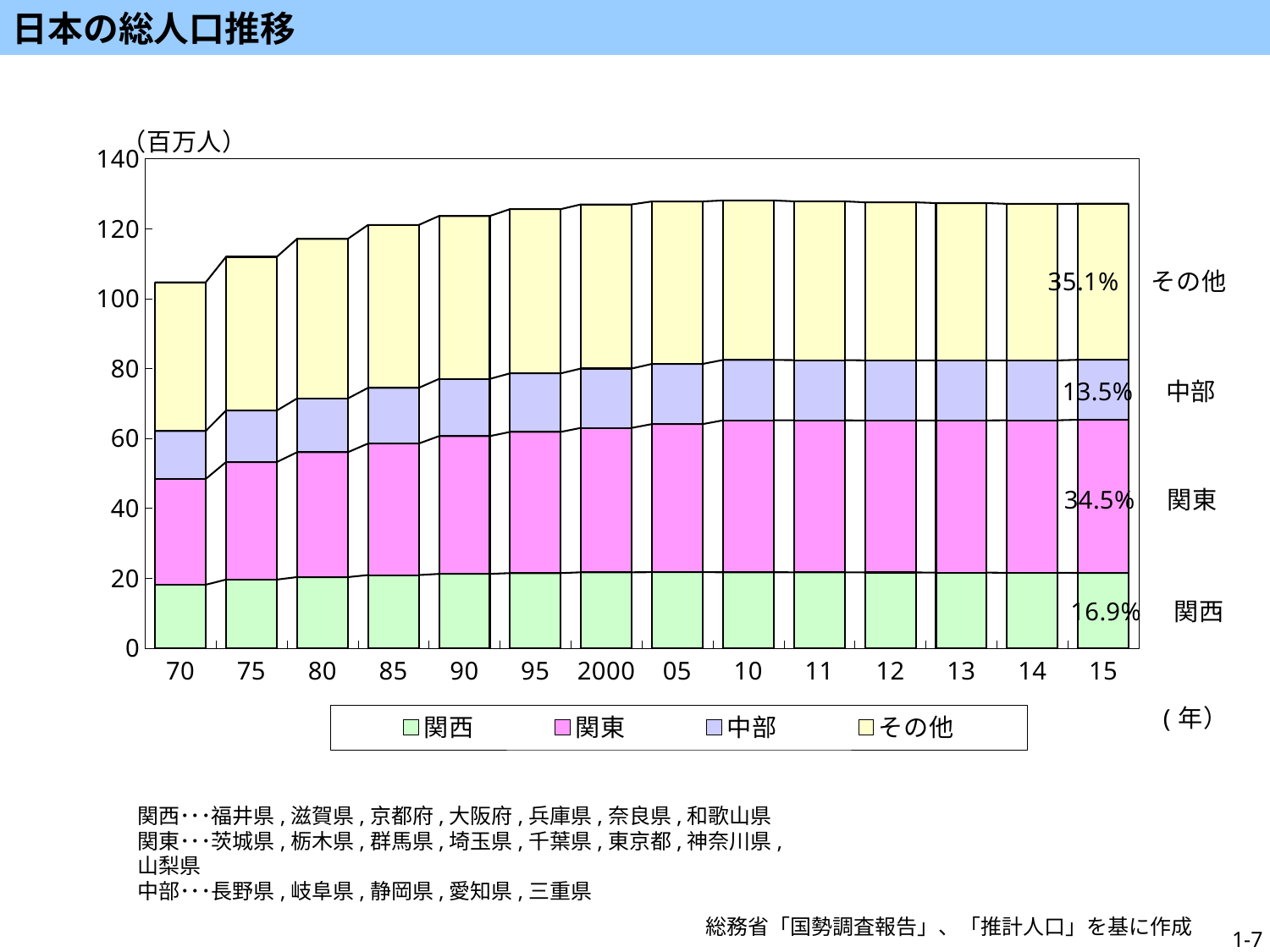
How many years are shown along the x axis? 14 What percentage share is shown for 中部 in 2015? 13.5% What percentage share is shown for 関西 in 2015? 16.9% Is the total population in 1970 greater or less than 100 (百万人)? greater What kind of chart is shown on the slide? stacked bar chart What percentage share is shown for その他 in 2015? 35.1% How many series does the legend list? 4 What percentage share is shown for 関東 in 2015? 34.5% Which has the larger share in 2015, 関東 or 関西? 関東 Does the total population rise or fall from 1970 to 2015? rises Which region has the smallest percentage share in 2015? 中部 What is the difference between the 2015 shares of その他 and 関東? 0.6%